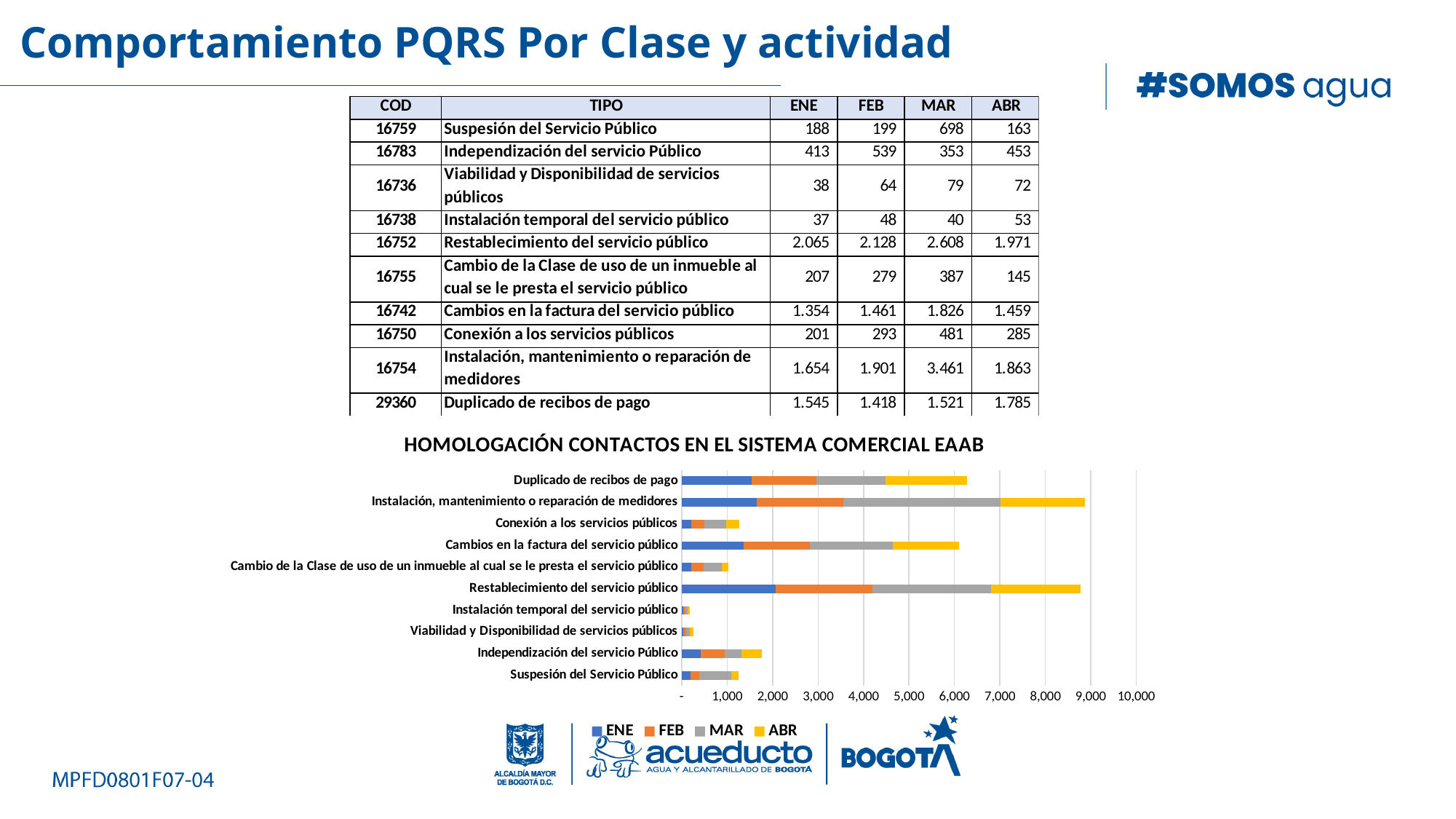
According to the table, what is the MAR value for 'Instalación, mantenimiento o reparación de medidores'? 3.461 Which bar is longer in the chart: 'Independización del servicio Público' or 'Suspesión del Servicio Público'? Independización del servicio Público Which series is shown in yellow in the chart legend? ABR Is the total bar for 'Restablecimiento del servicio público' greater or less than 8,000? greater Is the total bar for 'Conexión a los servicios públicos' greater or less than 2,000? less According to the table, what is the ABR value for 'Duplicado de recibos de pago'? 1.785 What kind of chart is shown under the title 'HOMOLOGACIÓN CONTACTOS EN EL SISTEMA COMERCIAL EAAB'? Stacked bar chart Which series is shown in blue in the chart legend? ENE Is the total bar for 'Cambios en la factura del servicio público' greater or less than 5,000? greater According to the table, what is the difference between the MAR and ENE values for 'Suspesión del Servicio Público'? 510 How many series does the legend of the chart list? 4 How many categories are plotted on the y axis of the chart? 10